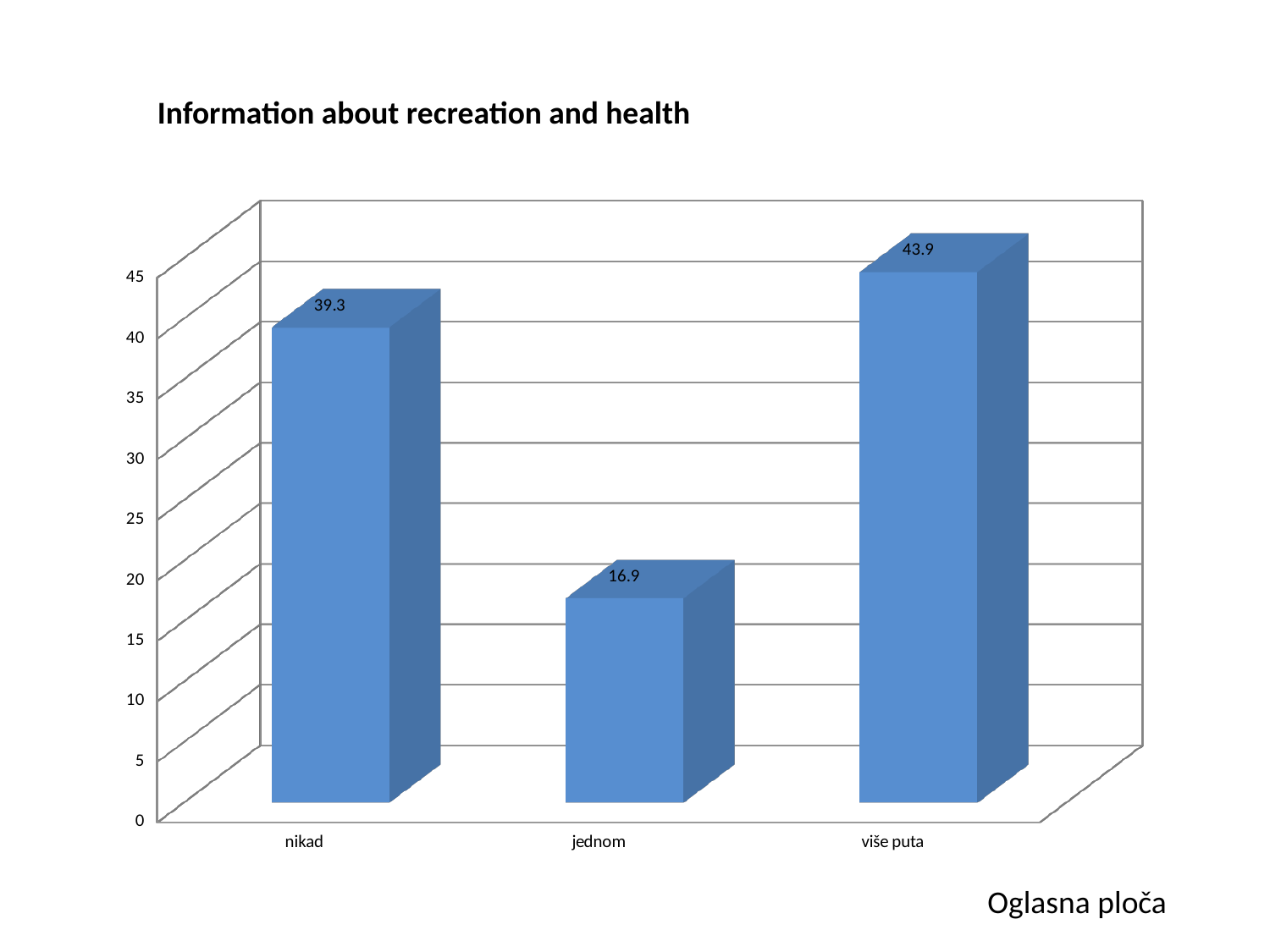
Which is larger, the value for nikad or the value for jednom? nikad Is the value for jednom greater or less than 20? less Which category has the lowest value? jednom What is the difference between the values for više puta and nikad? 4.6 What is the difference between the values for nikad and jednom? 22.4 What kind of chart is shown on the slide? bar chart What is the title of the chart? Information about recreation and health What is the value for nikad? 39.3 What is the value for jednom? 16.9 Which category has the highest value? više puta How many categories are shown on the x axis? 3 What is the value for više puta? 43.9